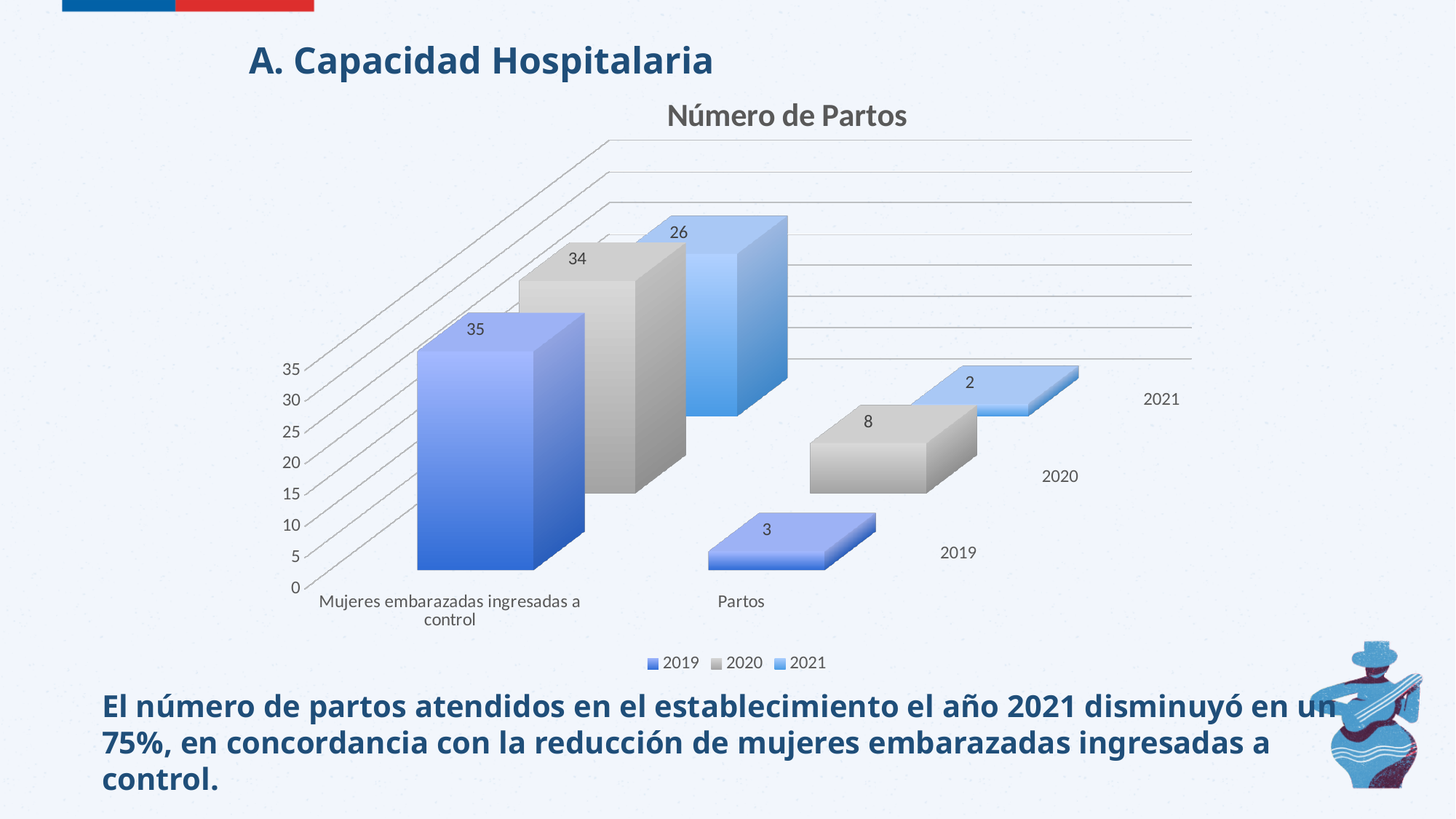
What is the title of the chart? Número de Partos What is the value for Partos in 2019? 3 How many series does the legend list? 3 What is the value for Mujeres embarazadas ingresadas a control in 2021? 26 What is the difference between the 2020 and 2021 values for Partos? 6 What is the value for Partos in 2021? 2 What type of chart is shown on the slide? bar chart How many categories are shown on the x axis? 2 What is the value for Partos in 2020? 8 What is the value for Mujeres embarazadas ingresadas a control in 2019? 35 What is the value for Mujeres embarazadas ingresadas a control in 2020? 34 Which year has the highest value for Partos? 2020